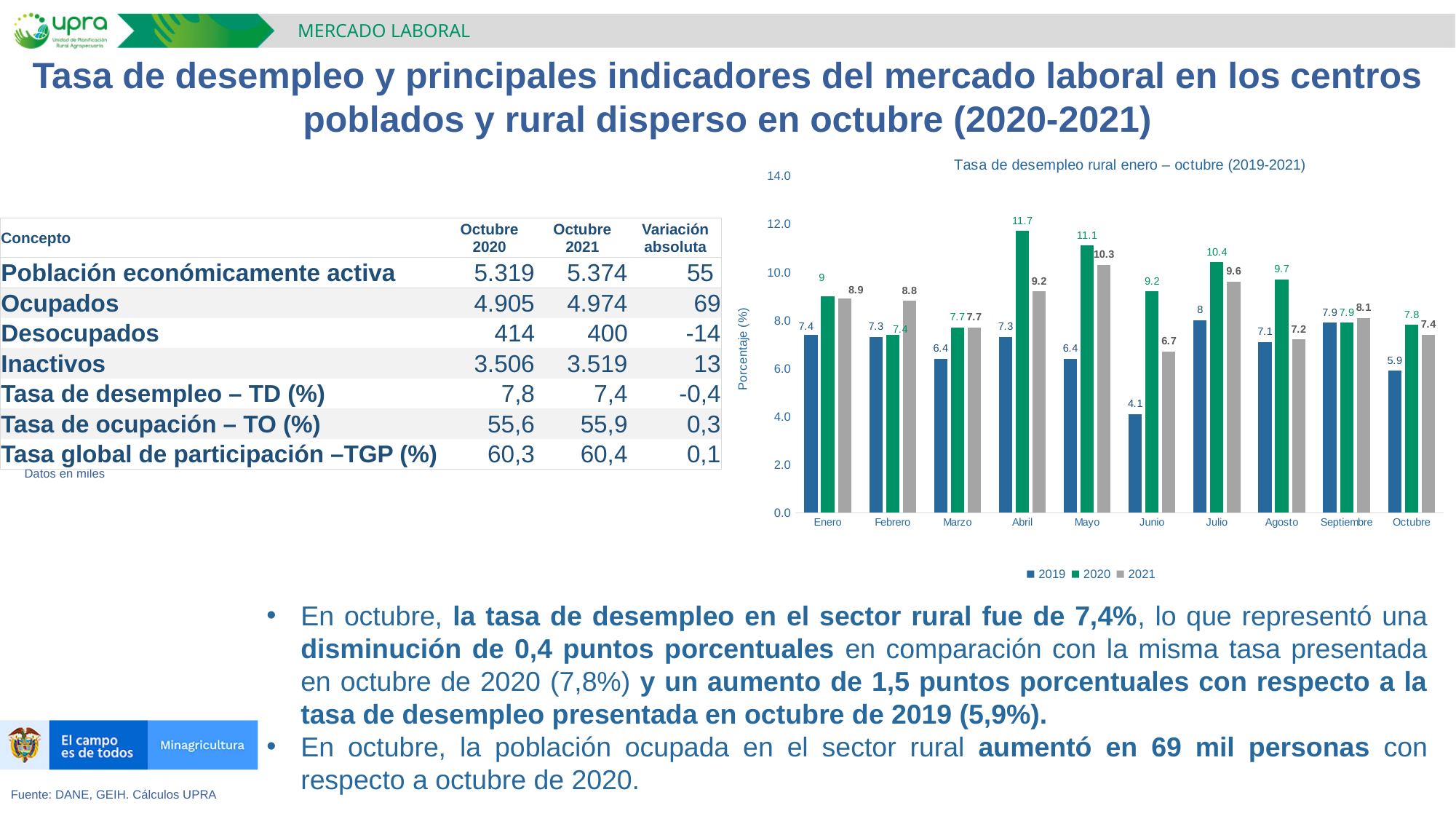
What kind of chart is shown on the slide? Bar chart Is the value for 2021 in Mayo greater or less than 10.0? greater What is the value for 2020 in Abril? 11.7 How many series does the chart legend list? 3 What is the value for 2021 in Octubre? 7.4 What is the value for 2019 in Junio? 4.1 Which month has the highest value for the 2020 series? Abril How many months are shown on the x axis of the chart? 10 What is the difference between the 2020 and 2019 values in Mayo? 4.7 Which is larger in Agosto, the 2020 value or the 2021 value? 2020 What is the title of the chart? Tasa de desempleo rural enero – octubre (2019-2021) Which month has the lowest value for the 2019 series? Junio